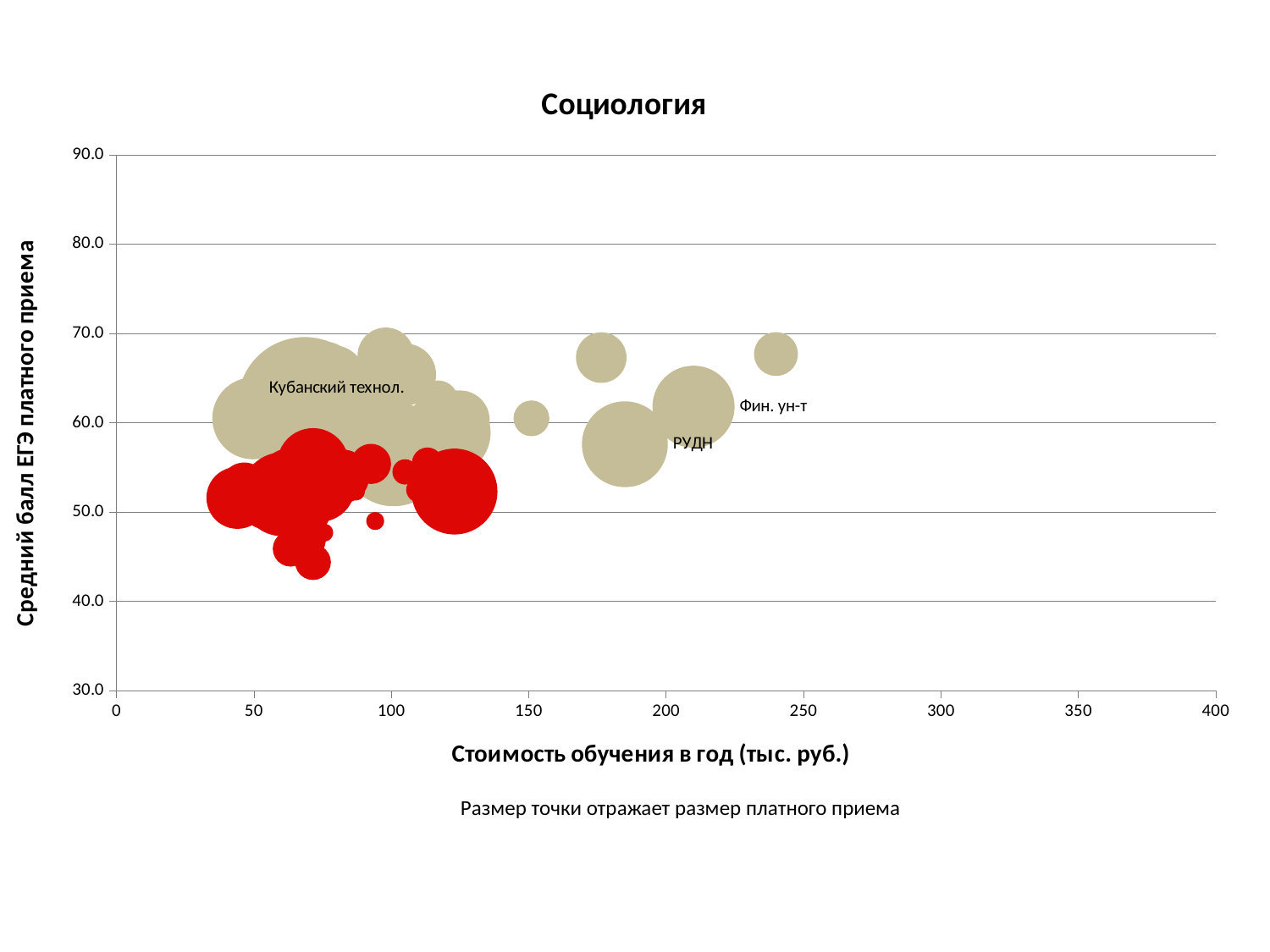
Is the x-axis value (cost per year) for Кубанский технол. greater or less than 100? less Which has the higher cost per year on the x axis, РУДН or Кубанский технол.? РУДН What is the highest value shown on the x axis? 400 Is the x-axis value of the rightmost bubble greater or less than 200? greater Is the average ЕГЭ score for Фин. ун-т greater or less than 70.0? less What is the title of the x axis of the chart? Стоимость обучения в год (тыс. руб.) What kind of chart is shown on the slide? bubble chart What is the title of the chart? Социология Which has the higher cost per year on the x axis, Фин. ун-т or Кубанский технол.? Фин. ун-т